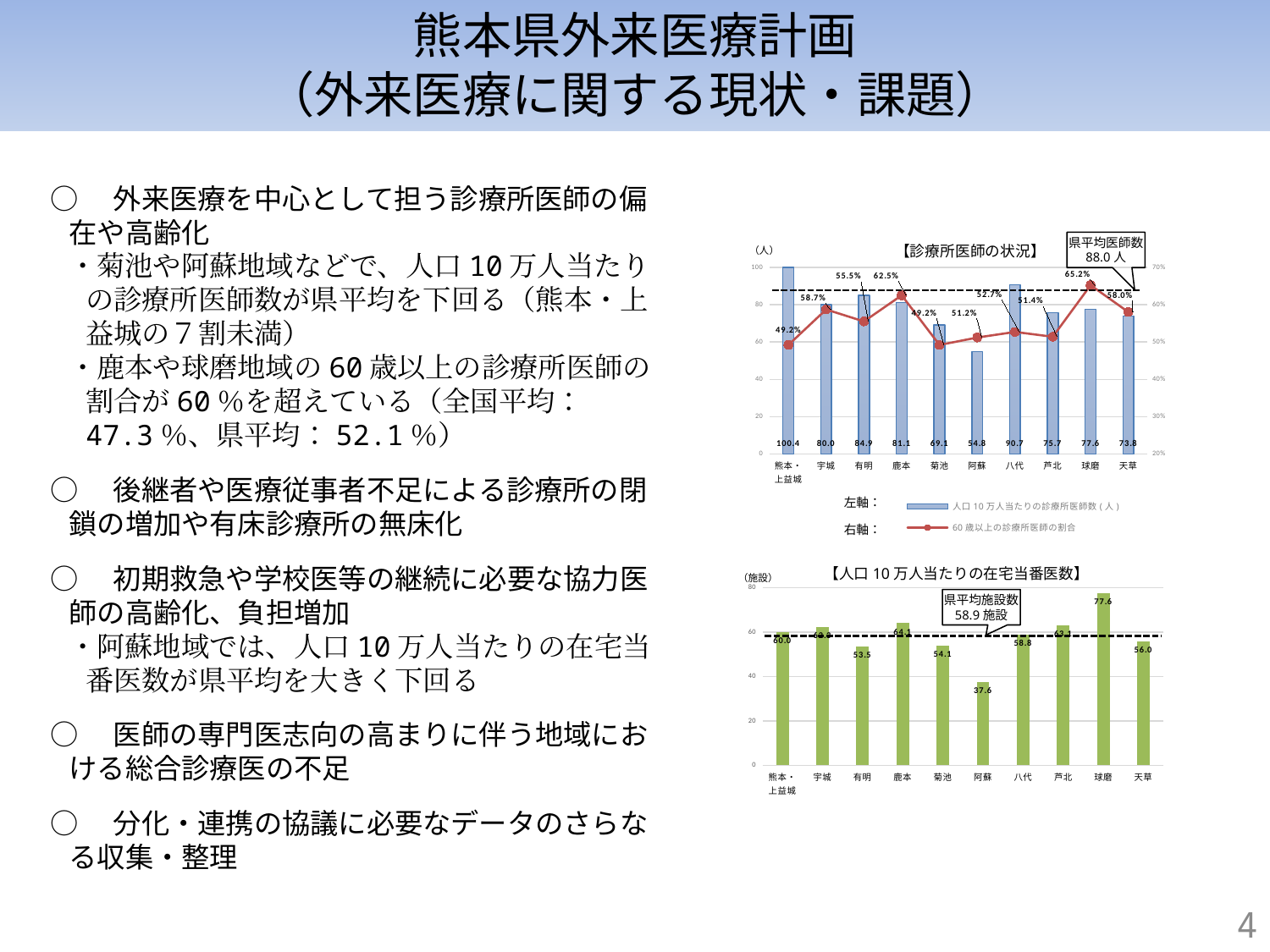
In the top chart 【診療所医師の状況】, which region has the highest bar value? 熊本・上益城 In the top chart 【診療所医師の状況】, what is the line value (60歳以上の診療所医師の割合) for 球磨? 65.2% In the top chart 【診療所医師の状況】, which region has the lowest bar value? 阿蘇 In the bottom chart 【人口10万人当たりの在宅当番医数】, which region has the highest value? 球磨 In the top chart 【診療所医師の状況】, what is the difference between the bar values for 八代 and 芦北? 15.0 In the top chart 【診療所医師の状況】, how many series does the legend list? 2 In the top chart 【診療所医師の状況】, what is the bar value for 阿蘇? 54.8 In the top chart 【診療所医師の状況】, what is the 県平均医師数 shown in the annotation? 88.0人 In the bottom chart 【人口10万人当たりの在宅当番医数】, is the value for 天草 greater or less than 60? less In the bottom chart 【人口10万人当たりの在宅当番医数】, how many regions are shown on the x axis? 10 In the bottom chart 【人口10万人当たりの在宅当番医数】, what is the value for 阿蘇? 37.6 In the top chart 【診療所医師の状況】, what is the bar value for 熊本・上益城? 100.4